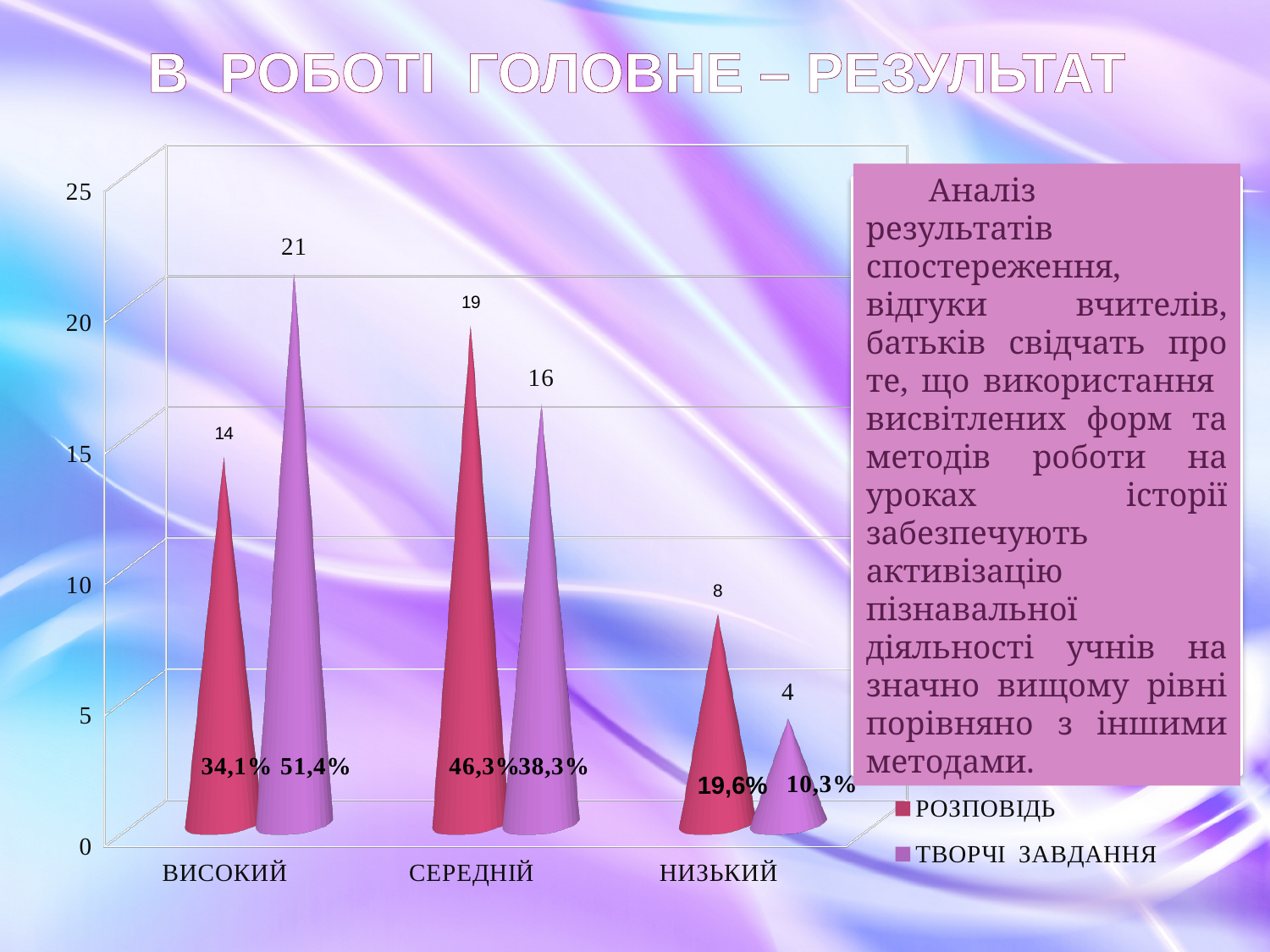
How many series does the legend list? 2 Which category has the lowest value for РОЗПОВІДЬ? НИЗЬКИЙ What is the value for ТВОРЧІ ЗАВДАННЯ in the НИЗЬКИЙ category? 4 What percentage label is shown for РОЗПОВІДЬ in the НИЗЬКИЙ category? 19,6% What kind of chart is shown on the slide? bar chart What is the difference between the ТВОРЧІ ЗАВДАННЯ and РОЗПОВІДЬ values in the ВИСОКИЙ category? 7 Which category has the highest value for ТВОРЧІ ЗАВДАННЯ? ВИСОКИЙ What is the value for ТВОРЧІ ЗАВДАННЯ in the ВИСОКИЙ category? 21 What is the value for РОЗПОВІДЬ in the СЕРЕДНІЙ category? 19 In the СЕРЕДНІЙ category, which series has the larger value, РОЗПОВІДЬ or ТВОРЧІ ЗАВДАННЯ? РОЗПОВІДЬ How many categories are shown on the x axis? 3 What is the value for РОЗПОВІДЬ in the ВИСОКИЙ category? 14